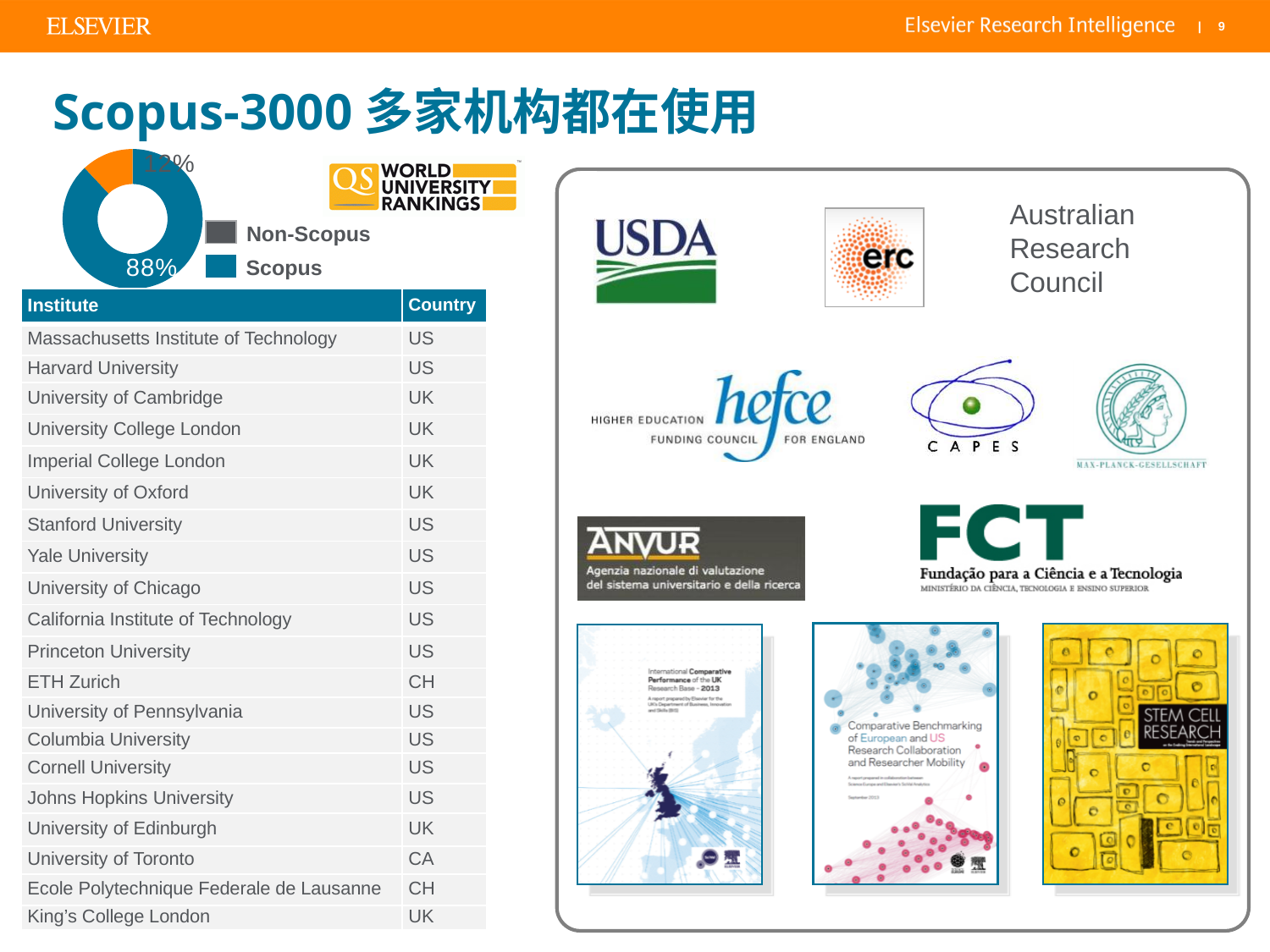
How many entries does the pie chart legend list? 2 What is the difference in percentage points between the Scopus and Non-Scopus slices? 76 How many slices does the pie chart have? 2 Is the Scopus share in the pie chart greater or less than 50%? greater Which is larger in the pie chart, Scopus or Non-Scopus? Scopus What percentage of the pie chart is labelled Non-Scopus? 12% What percentage of the pie chart is labelled Scopus? 88% Which slice of the pie chart is the smallest? Non-Scopus What are the two legend entries of the pie chart? Non-Scopus and Scopus Which slice of the pie chart is the largest? Scopus What kind of chart is shown on the left of the slide? doughnut chart What colour is the Scopus slice in the pie chart? blue